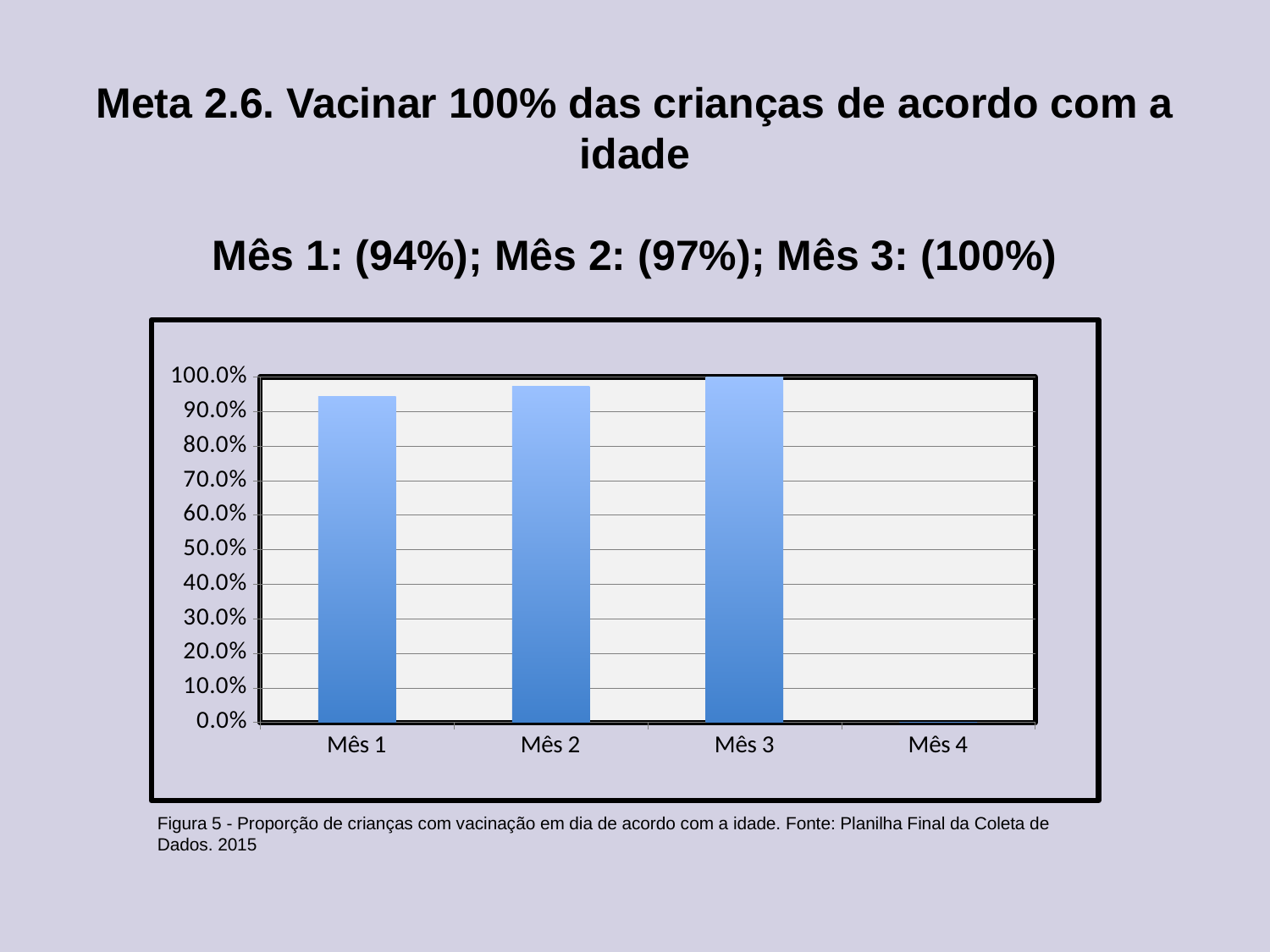
Which category on the x axis has no bar plotted? Mês 4 Which month has the highest value among the plotted bars? Mês 3 What is the value for Mês 3? 100% Which month has the lowest value among the plotted bars? Mês 1 Is the value for Mês 1 greater or less than 90.0%? greater What is the value for Mês 2? 97% Do the values rise or fall from Mês 1 to Mês 3? rise Which is larger, the value for Mês 2 or the value for Mês 1? Mês 2 How many category labels are shown on the x axis? 4 What is the difference between the values for Mês 3 and Mês 1? 6% What kind of chart is shown on the slide? bar chart What is the value for Mês 1? 94%